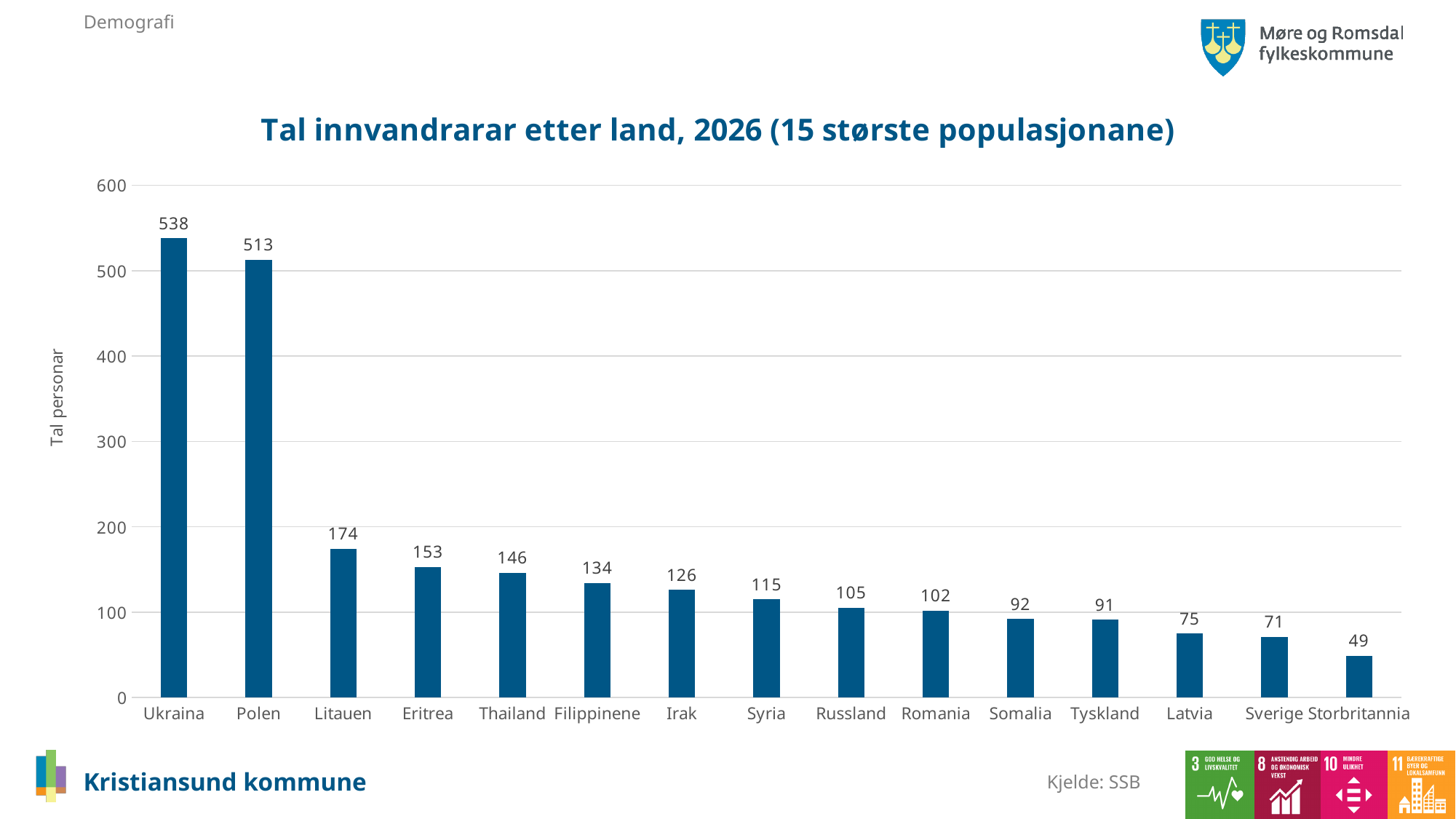
Is the value for Polen greater or less than 500? greater How many countries are shown on the chart? 15 What kind of chart is this? bar chart What is the value for Tyskland? 91 What is the difference between the values for Litauen and Storbritannia? 125 Which country has the highest value? Ukraina What is the value for Ukraina? 538 Which country has the lowest value? Storbritannia What is the value for Eritrea? 153 What is the difference between the values for Ukraina and Polen? 25 What is the title of the chart? Tal innvandrarar etter land, 2026 (15 største populasjonane) Which is larger, the value for Irak or the value for Syria? Irak